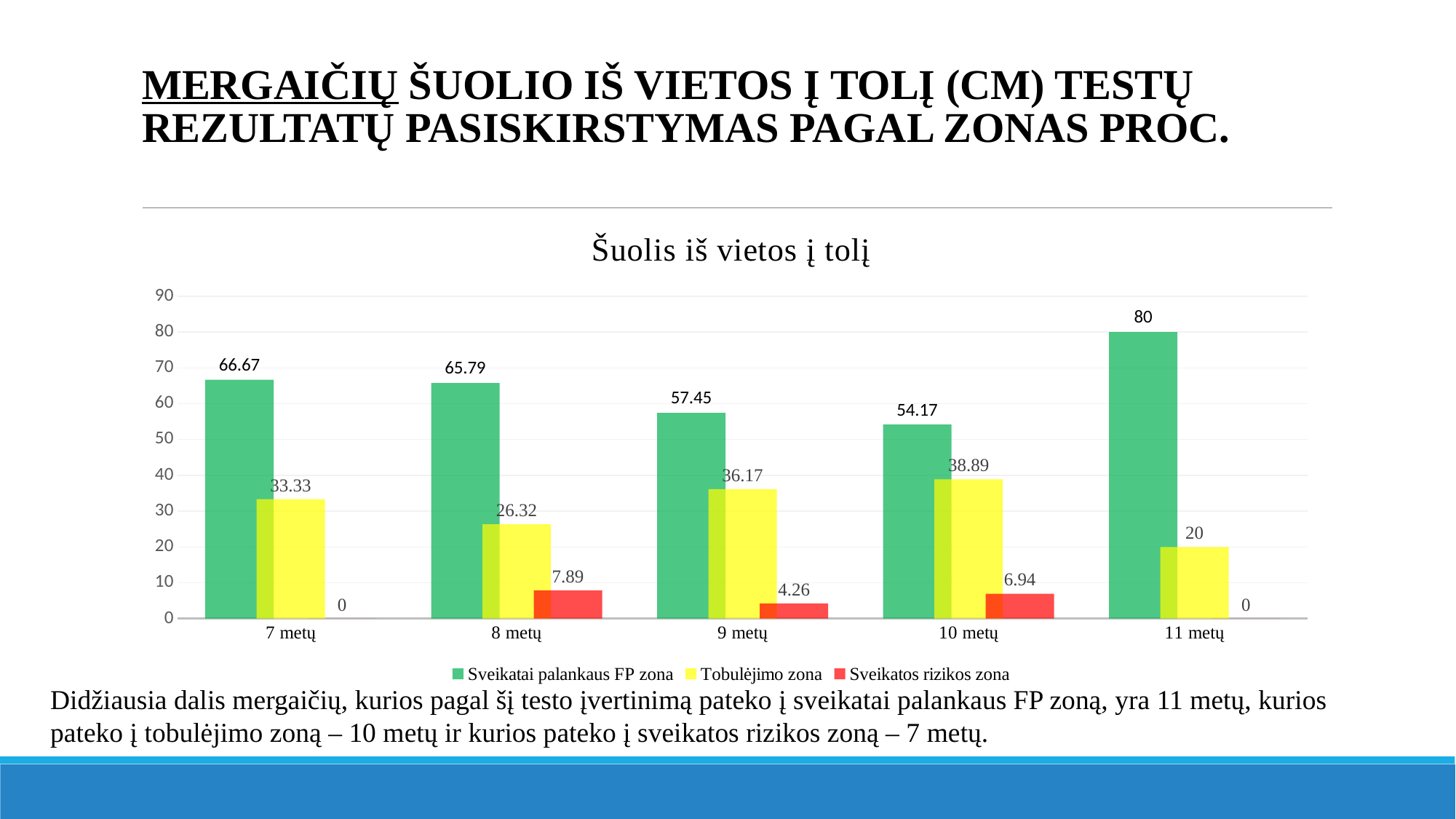
What is the difference between the 'Sveikatai palankaus FP zona' values for 7 metų and 10 metų? 12.5 What kind of chart is shown on the slide? bar chart Which is larger: the 'Sveikatos rizikos zona' value for 8 metų or for 10 metų? 8 metų How many series does the legend list? 3 What is the value for 'Sveikatos rizikos zona' at 8 metų? 7.89 What is the value for 'Tobulėjimo zona' at 9 metų? 36.17 What is the value for 'Sveikatai palankaus FP zona' at 11 metų? 80 What is the title of the chart? Šuolis iš vietos į tolį Is the value for 'Tobulėjimo zona' at 10 metų greater or less than 30? greater Which age group has the highest value for 'Sveikatai palankaus FP zona'? 11 metų Which age group has the lowest value for 'Tobulėjimo zona'? 11 metų How many age groups are shown on the x axis? 5